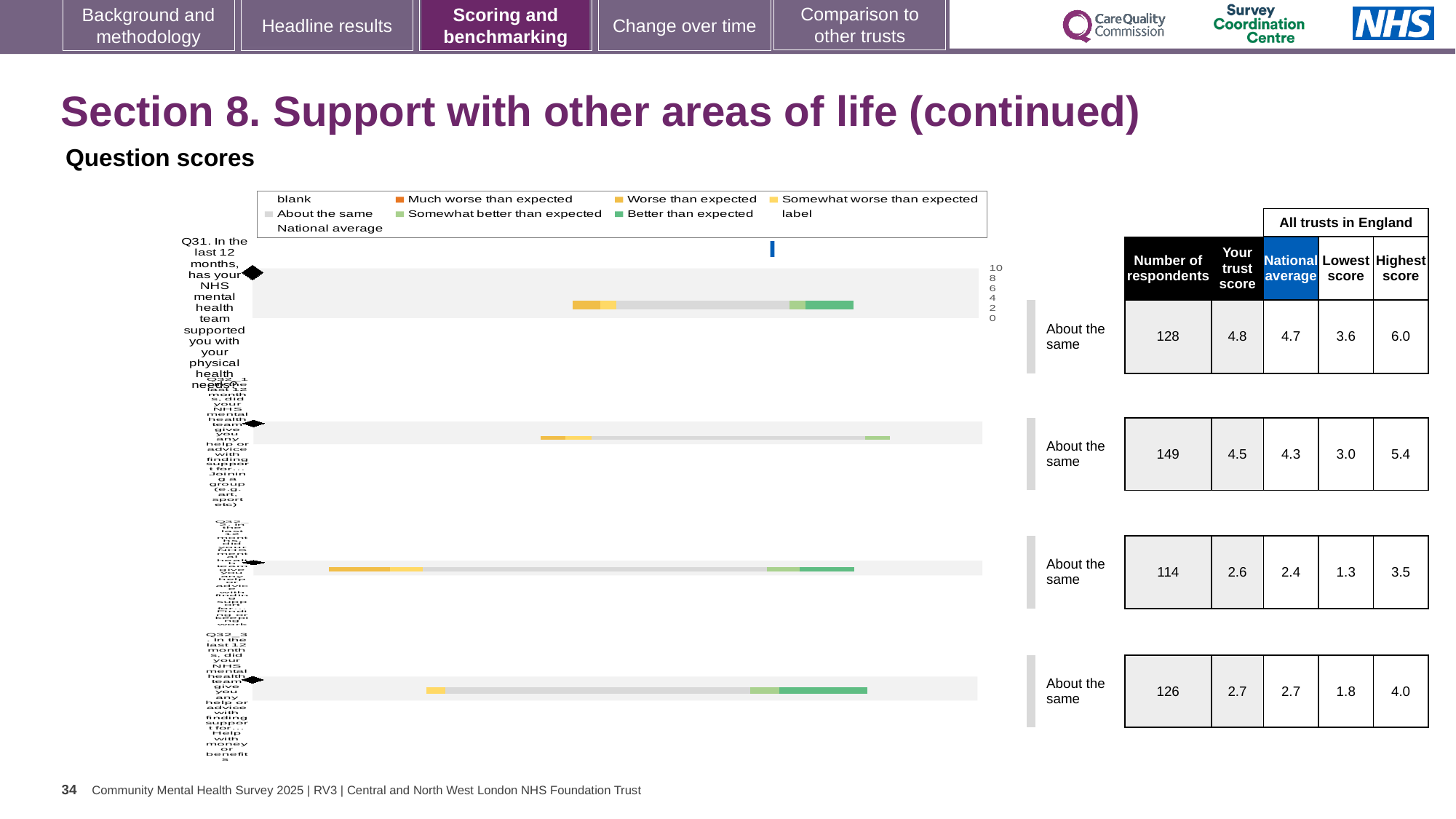
What is the difference between the trust score and the national average for Q31? 0.1 How many respondents are listed for Q31? 128 What is the national average for Q31? 4.7 Which of the four question rows has the highest number of respondents? The second row (149) What kind of chart is shown on the slide? bar chart What benchmark category is shown next to the Q31 bar? About the same What is the difference between the highest score and the lowest score for Q31? 2.4 What is the highest score across all trusts in England for Q31? 6.0 Which is larger for Q31: the trust score or the national average? Your trust score (4.8) How many question bars are plotted in the chart? 4 Which of the four question rows has the lowest 'Your trust score'? The third row (2.6) What is the 'Your trust score' for Q31 (support with physical health needs)? 4.8